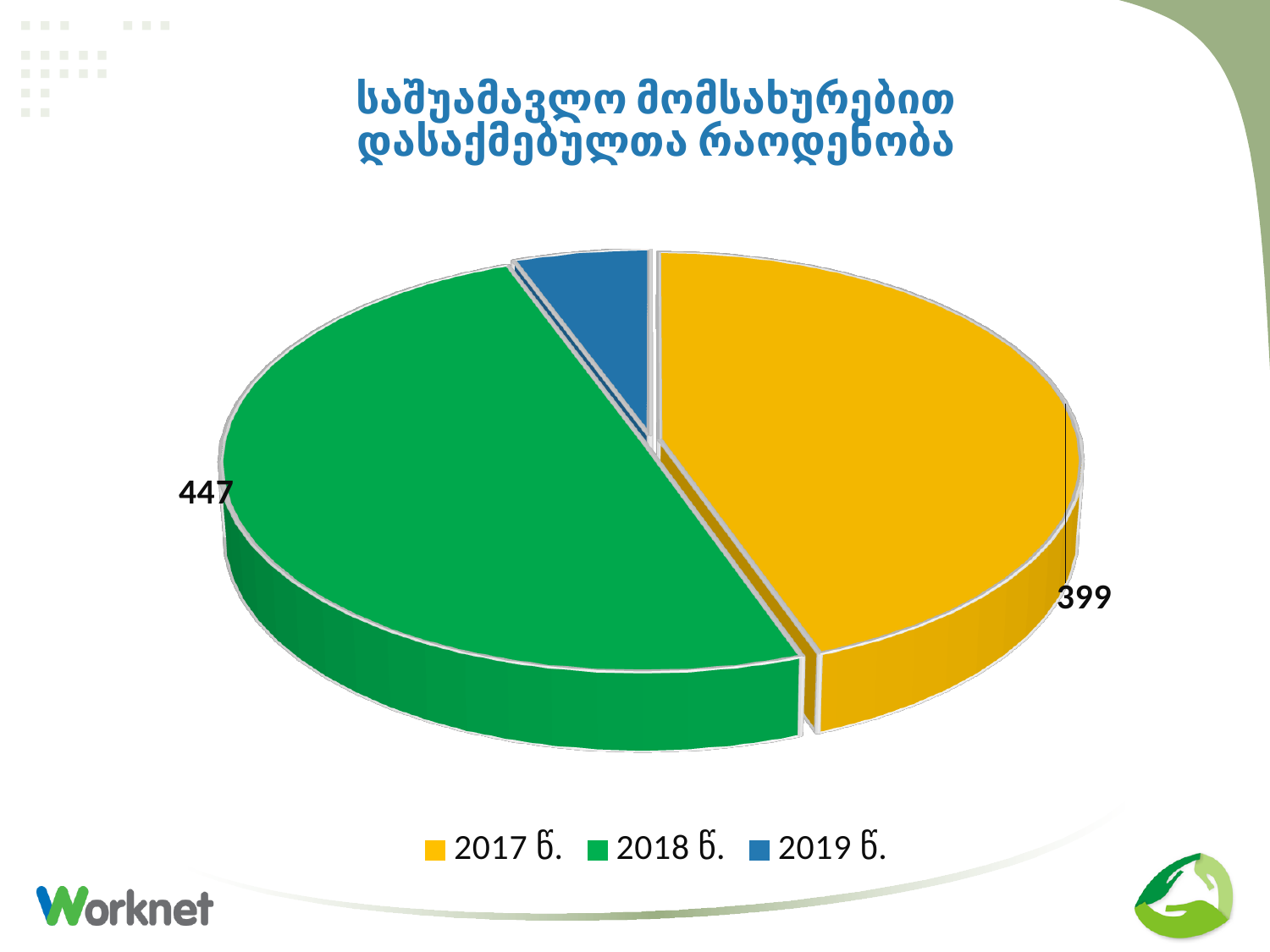
How many entries does the legend list? 3 How many slices does the pie chart have? 3 Which year has the smallest slice in the pie chart? 2019 წ. What is the title of the chart? საშუამავლო მომსახურებით დასაქმებულთა რაოდენობა What is the value for 2017 წ. in the pie chart? 399 What is the value for 2018 წ. in the pie chart? 447 What is the difference between the values for 2018 წ. and 2017 წ.? 48 Which year has the largest slice in the pie chart? 2018 წ. What colour is the slice for 2019 წ.? Blue Which slice is larger, 2017 წ. or 2019 წ.? 2017 წ. Which is larger, the value for 2017 წ. or the value for 2018 წ.? 2018 წ. What kind of chart is shown on the slide? Pie chart